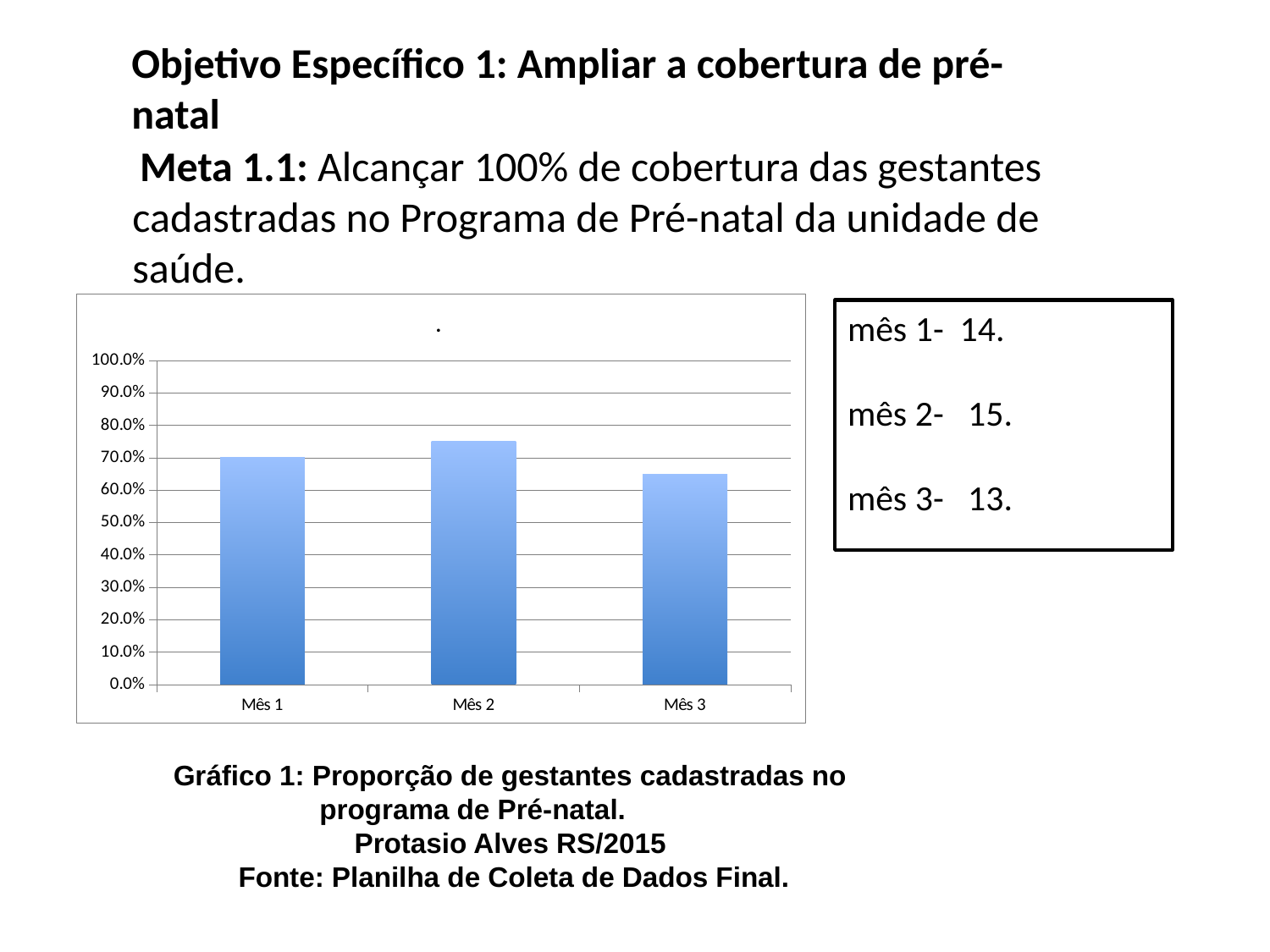
Which is larger, the value for Mês 2 or the value for Mês 3? Mês 2 What is the highest value shown on the chart's vertical axis? 100.0% Do the values rise or fall from Mês 2 to Mês 3? fall What kind of chart is shown on the slide? bar chart Is the value for Mês 2 greater or less than 70.0%? greater Is the value for Mês 1 greater or less than 60.0%? greater Which month has the highest bar on the chart? Mês 2 Which is larger, the value for Mês 1 or the value for Mês 2? Mês 2 Is the value for Mês 3 greater or less than 70.0%? less How many categories (months) are plotted on the chart? 3 Which month has the lowest bar on the chart? Mês 3